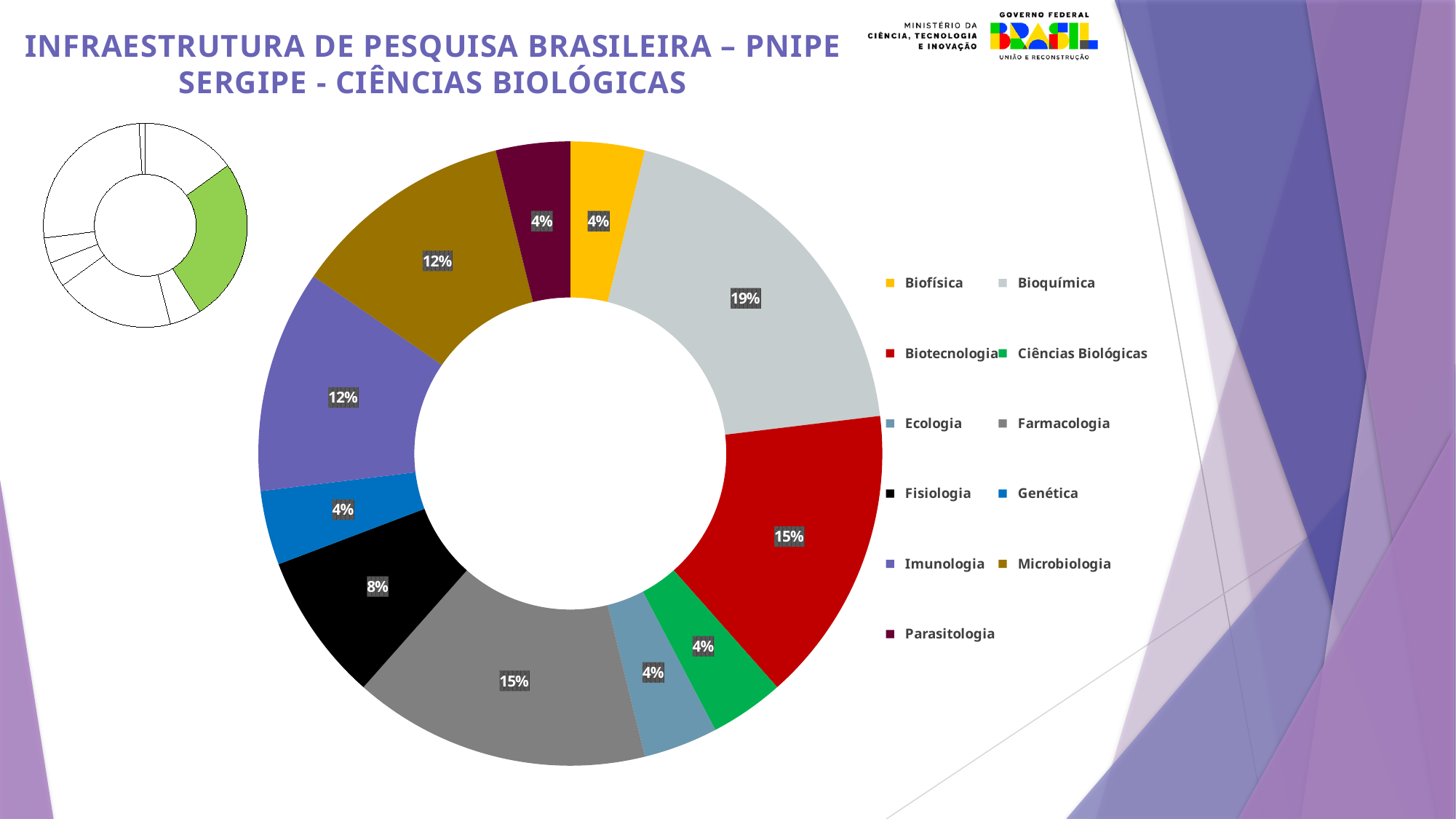
In the large doughnut chart, what is the difference between the shares of Bioquímica and Biotecnologia? 4% In the large doughnut chart, which has a larger share, Genética or Imunologia? Imunologia What kind of chart is the large chart in the centre of the slide? doughnut chart In the large doughnut chart, what colour is the Biotecnologia slice? red How many categories are listed in the legend of the large doughnut chart? 11 In the large doughnut chart, what share of the whole does Biotecnologia represent? 15% In the large doughnut chart, what percentage is shown for Bioquímica? 19% In the large doughnut chart, what percentage is shown for Fisiologia? 8% In the large doughnut chart, what percentage is shown for Imunologia? 12% In the large doughnut chart, what is the difference between the shares of Microbiologia and Fisiologia? 4% In the large doughnut chart, which category has the largest share? Bioquímica In the large doughnut chart, which has a larger share, Farmacologia or Fisiologia? Farmacologia